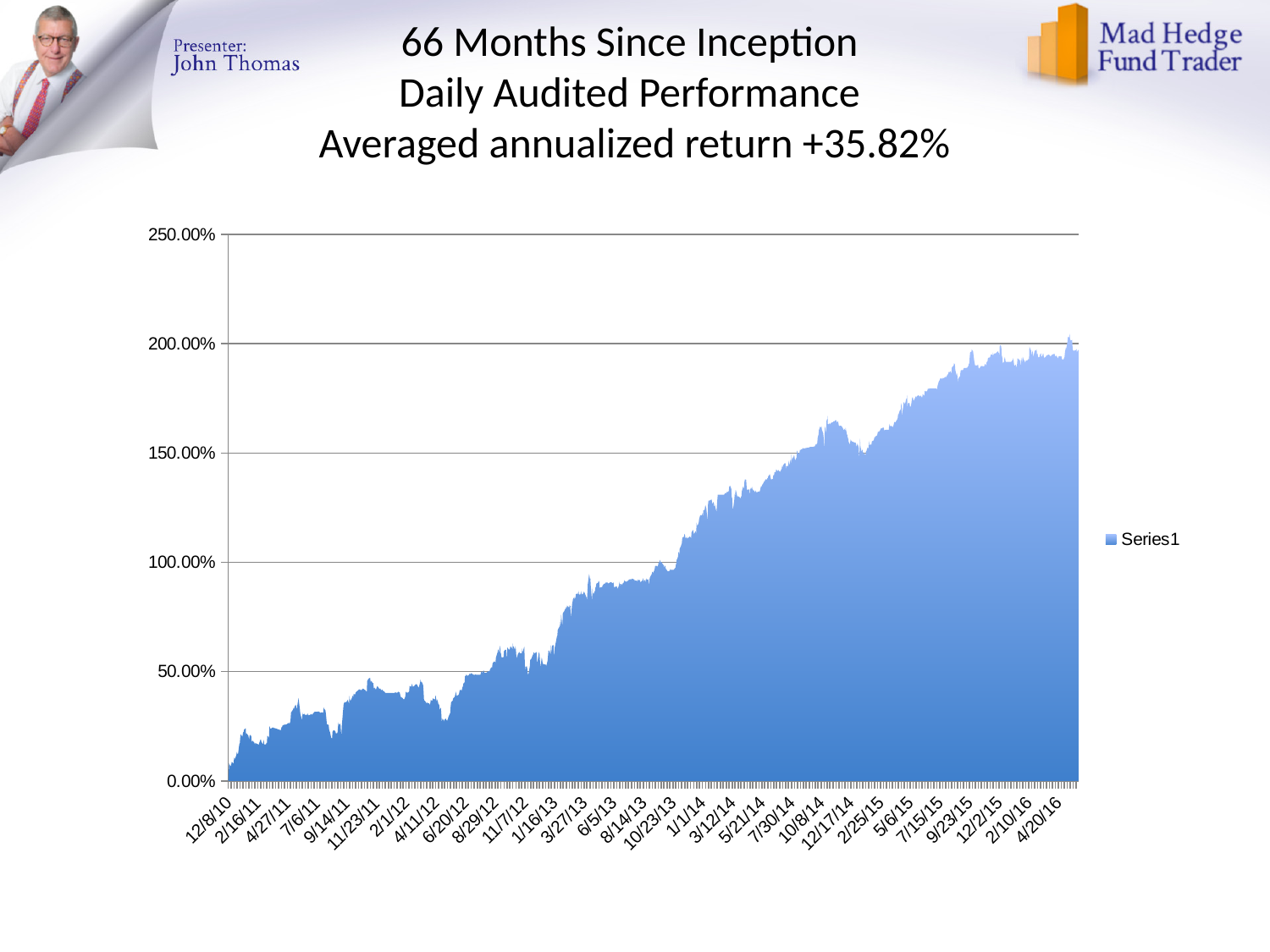
Is the value at 1/1/14 greater or less than 100.00%? greater How many series does the legend list? 1 Is the value at 5/6/15 greater or less than 150.00%? greater Do the values generally rise or fall from 12/8/10 to 4/20/16? rise Is the value at 4/20/16 greater or less than 150.00%? greater What kind of chart is shown on the slide? area chart What is the highest value shown on the y axis? 250.00% What is the name of the series shown in the legend? Series1 Is the value near the end of the series (4/20/16) larger or smaller than the value near the start (12/8/10)? larger